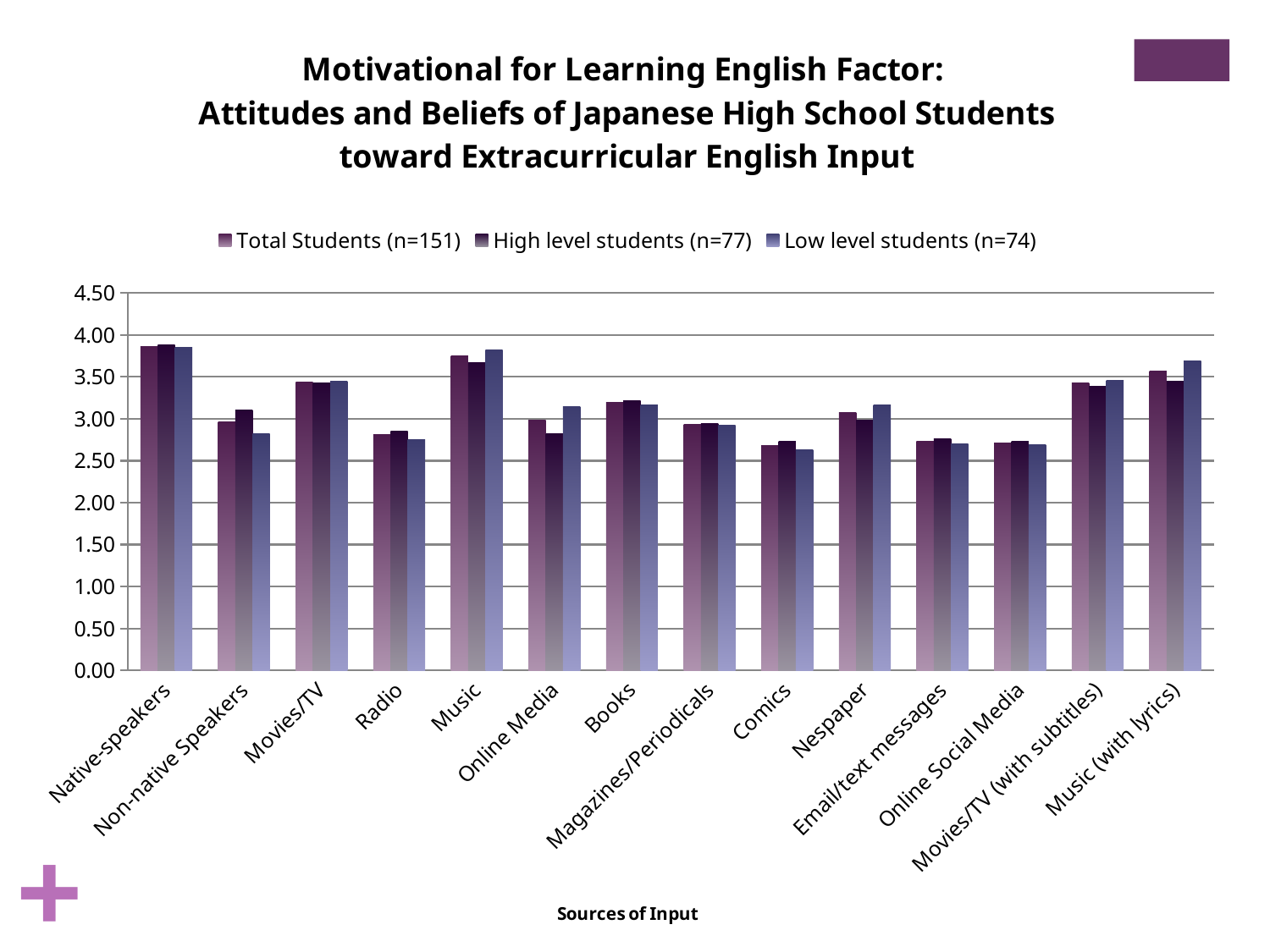
Which category has the highest value for Total Students (n=151)? Native-speakers For Online Media, which is larger: the High level students (n=77) value or the Low level students (n=74) value? Low level students (n=74) For Non-native Speakers, which is larger: the High level students (n=77) value or the Low level students (n=74) value? High level students (n=77) What is the sample size given in the legend for High level students? n=77 How many source-of-input categories are shown on the x axis? 14 Is the Low level students (n=74) value for Music (with lyrics) greater or less than 3.50? greater Is the Total Students (n=151) value for Comics greater or less than 3.00? less How many series does the legend list? 3 Is the Low level students (n=74) value for Non-native Speakers greater or less than 3.00? less What kind of chart is shown on the slide? bar chart What is the title of the x axis? Sources of Input